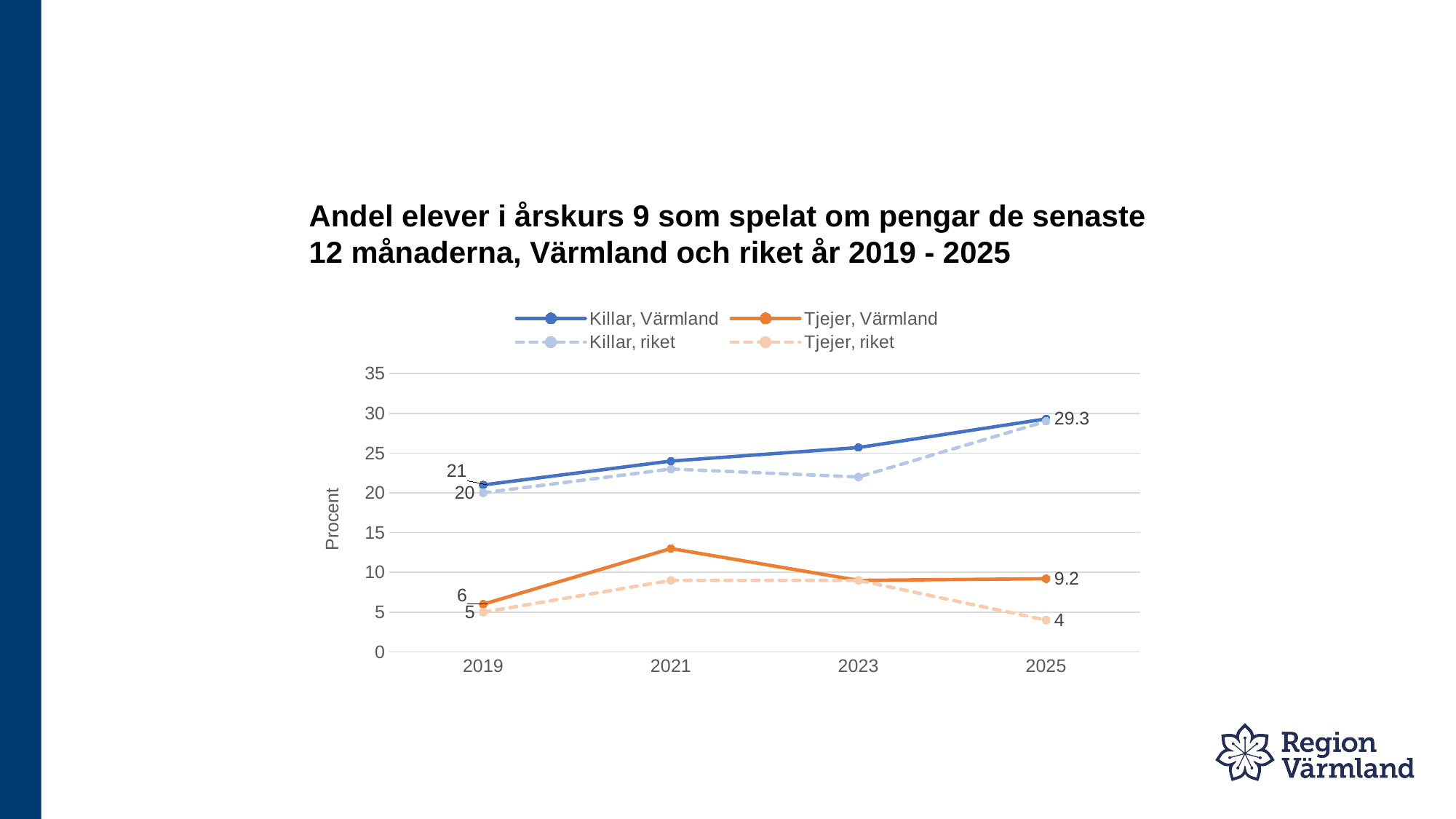
What is the label on the y axis? Procent What is the value for Killar, riket in 2019? 20 How many years are shown on the x axis? 4 What is the difference between Tjejer, Värmland and Tjejer, riket in 2025? 5.2 What is the value for Tjejer, riket in 2025? 4 How many series does the legend list? 4 What type of chart is shown on the slide? Line chart What is the value for Tjejer, Värmland in 2025? 9.2 What is the value for Killar, Värmland in 2019? 21 What is the value for Tjejer, Värmland in 2019? 6 Does the Killar, Värmland line rise or fall from 2019 to 2025? Rises Is the value for Tjejer, Värmland in 2021 greater or less than 10? greater